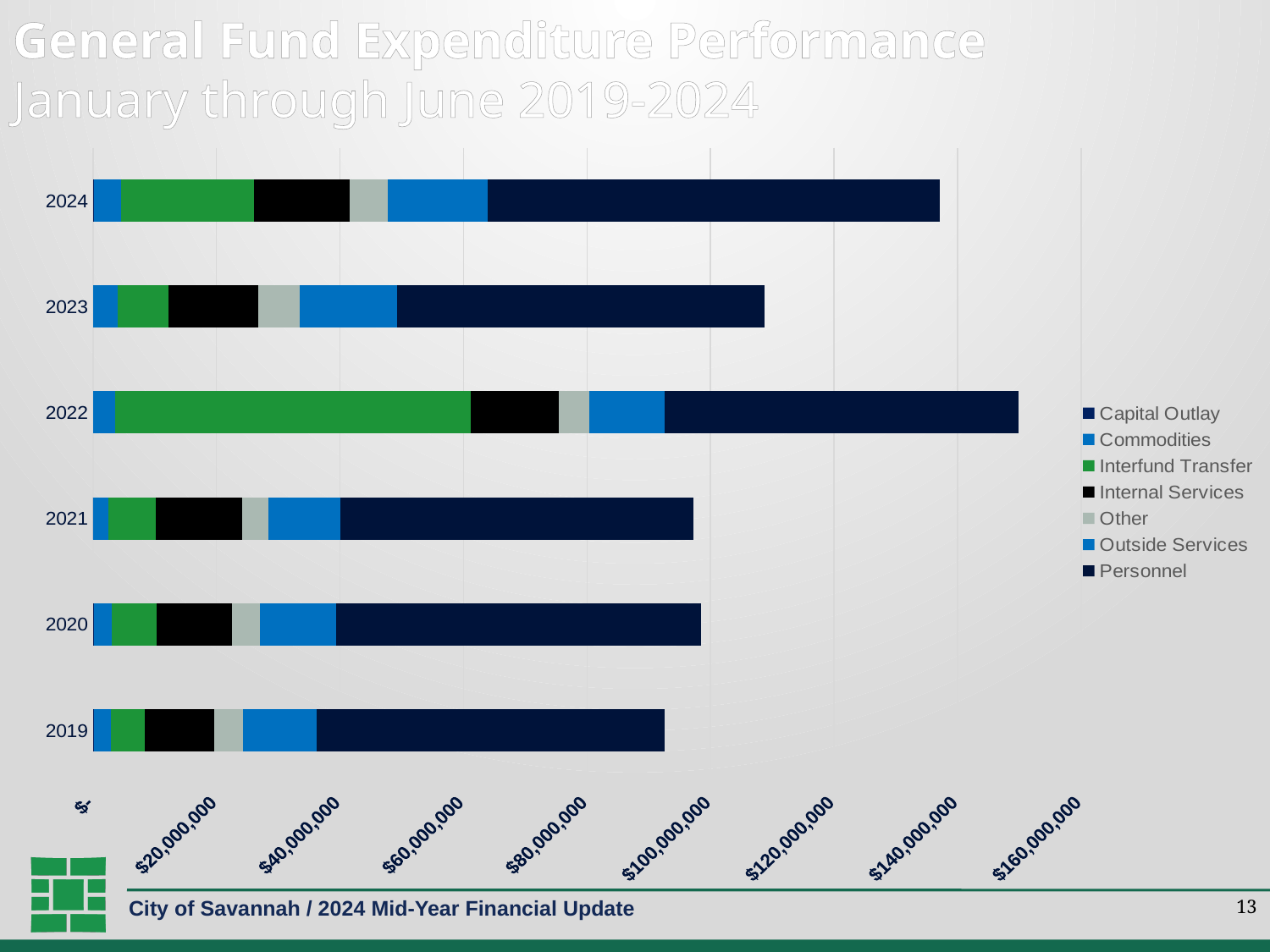
Is the total expenditure bar for 2023 greater or less than $100,000,000? greater Which year has the smallest total General Fund expenditure bar? 2019 How many years (categories) are plotted on the chart? 6 Is the total expenditure bar for 2019 greater or less than $100,000,000? less What kind of chart is shown on the slide? Stacked bar chart Which year has the largest Interfund Transfer segment? 2022 Which series is shown in green in the legend? Interfund Transfer Which year has the largest total General Fund expenditure bar? 2022 Is the total expenditure bar for 2024 greater or less than $120,000,000? greater How many series does the legend list? 7 Is the total bar for 2022 larger or smaller than the total bar for 2024? larger